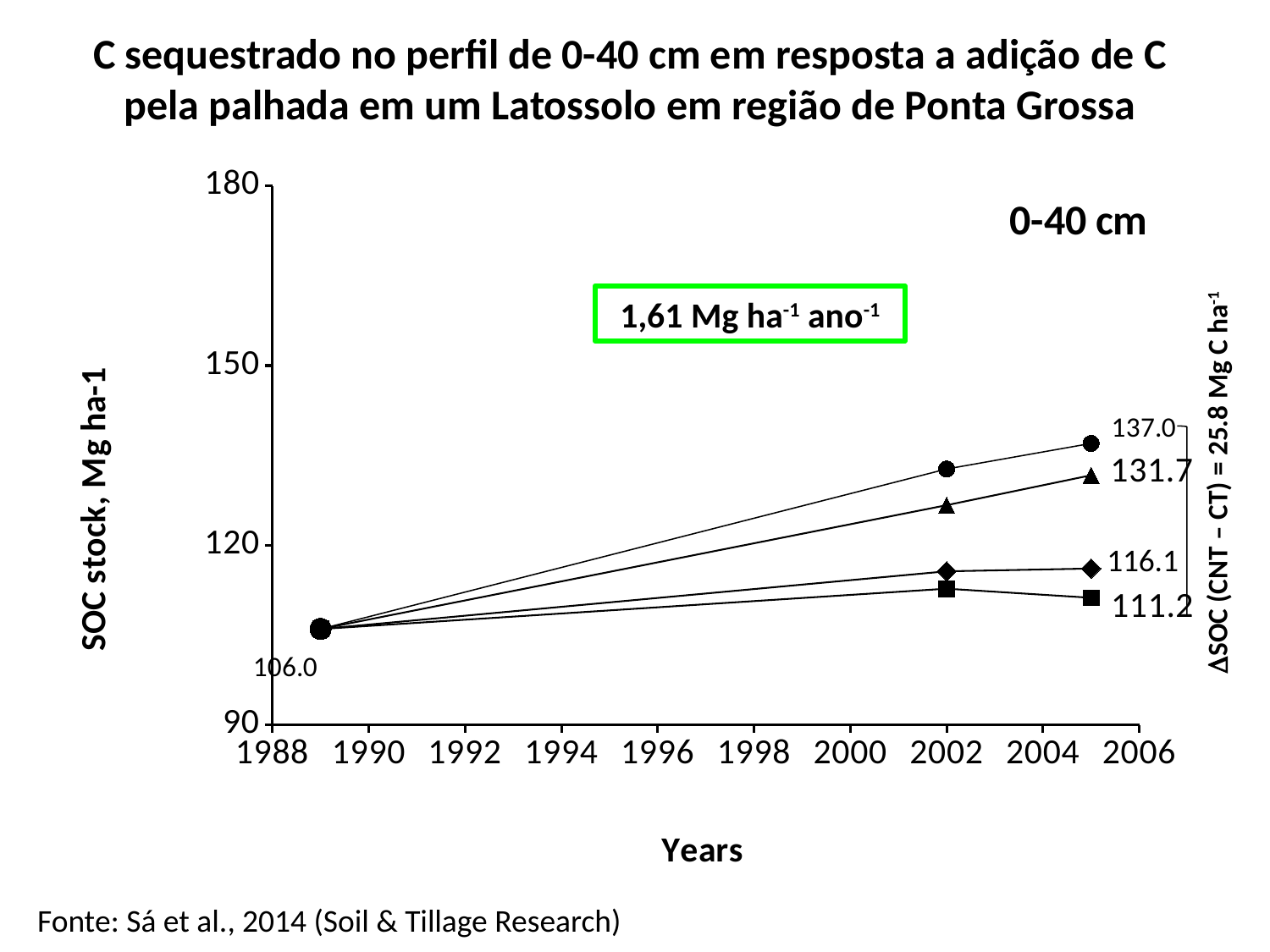
What is the label on the y axis? SOC stock, Mg ha-1 What is the difference between the 2005 values of the circle-marker series (137.0) and the square-marker series (111.2)? 25.8 Is the 2002 value for the series with circle markers greater or less than 120? greater By how much did the circle-marker series increase from 1989 (106.0) to 2005 (137.0)? 31.0 What is the 2005 value labelled for the series with triangle markers? 131.7 What is the 2005 value labelled for the series with square markers? 111.2 What is the 2005 value labelled for the series with circle markers? 137.0 Which series has the lowest labelled value in 2005? the series with square markers (111.2) What is the SOC stock value labelled at the starting point in 1989? 106.0 Which series has the highest labelled value in 2005? the series with circle markers (137.0) What kind of chart is shown on the slide? line chart How many lines are plotted on the chart? 4